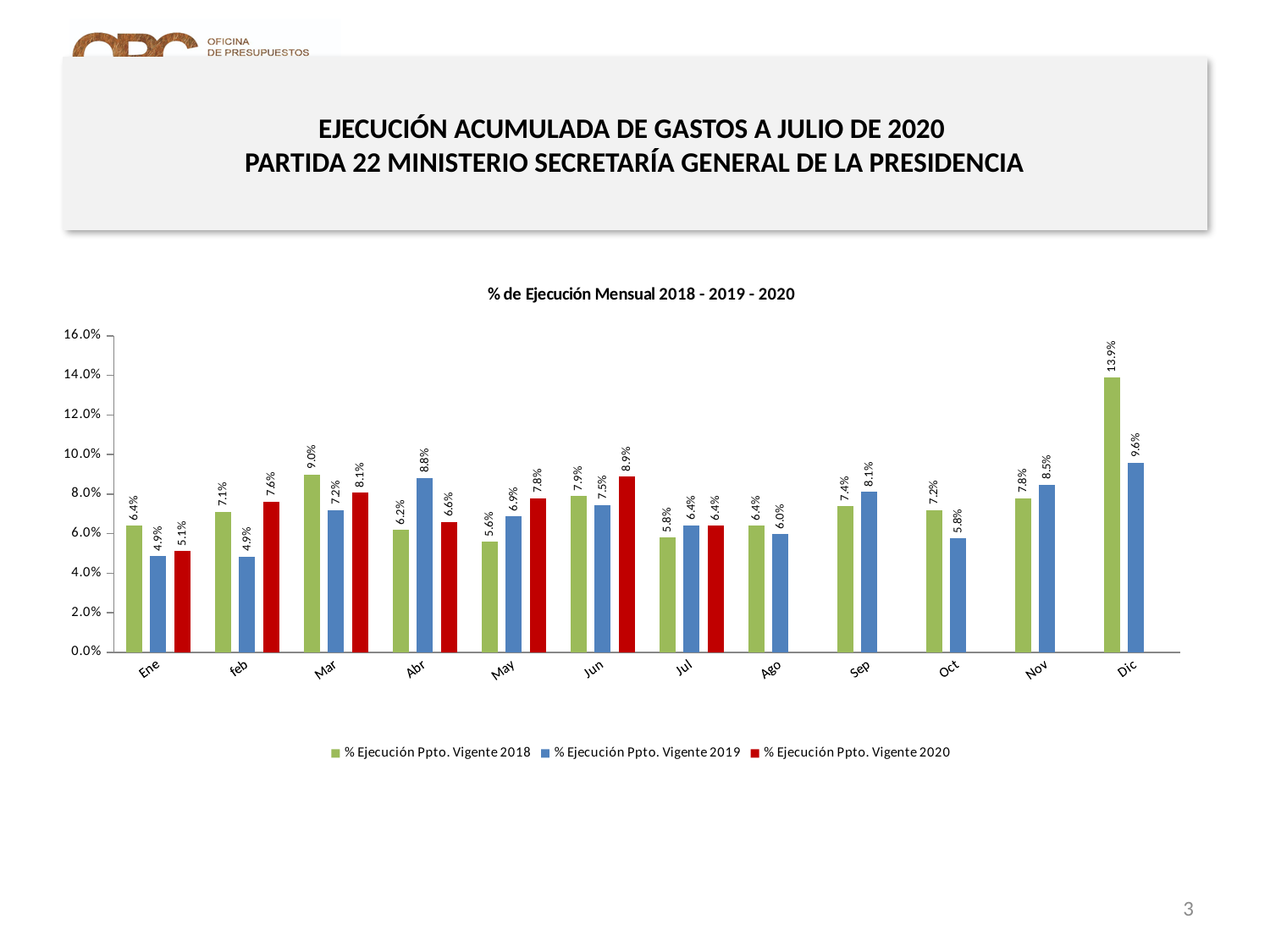
What is the value for Abr in the % Ejecución Ppto. Vigente 2019 series? 8.8% How many months are shown on the x axis? 12 Which month has the lowest value in the % Ejecución Ppto. Vigente 2018 series? May What is the value for Jun in the % Ejecución Ppto. Vigente 2020 series? 8.9% Is the value for Dic in the 2018 series greater or less than 12.0%? greater What kind of chart is shown on the slide? Bar chart What is the title of the chart? % de Ejecución Mensual 2018 - 2019 - 2020 What is the difference between the 2018 and 2019 values for Dic? 4.3% Which is larger for Abr: the 2018 value or the 2019 value? 2019 What is the value for Mar in the % Ejecución Ppto. Vigente 2018 series? 9.0% Which month has the highest value in the % Ejecución Ppto. Vigente 2018 series? Dic How many series does the legend list? 3